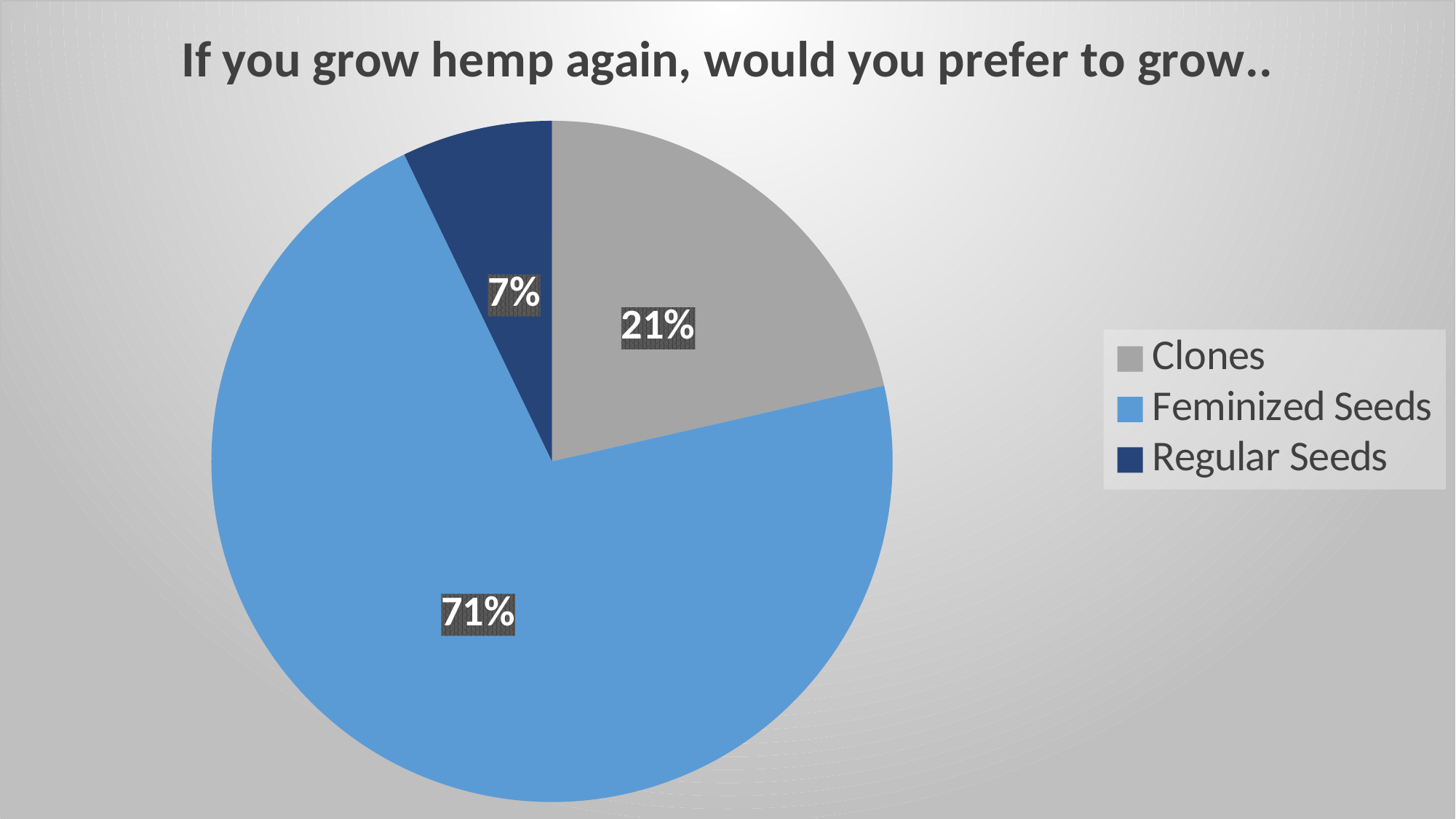
Which category has the smallest slice? Regular Seeds What share of the pie is Clones? 21% What kind of chart is shown on the slide? pie chart What share of the pie is Feminized Seeds? 71% What share of the pie is Regular Seeds? 7% What is the difference in percentage points between Clones and Regular Seeds? 14 What is the difference in percentage points between Feminized Seeds and Clones? 50 What is the title of the chart? If you grow hemp again, would you prefer to grow.. How many categories does the pie chart show? 3 Which colour represents Regular Seeds in the legend? dark blue Which is larger, the share for Clones or the share for Regular Seeds? Clones Which category has the largest slice? Feminized Seeds